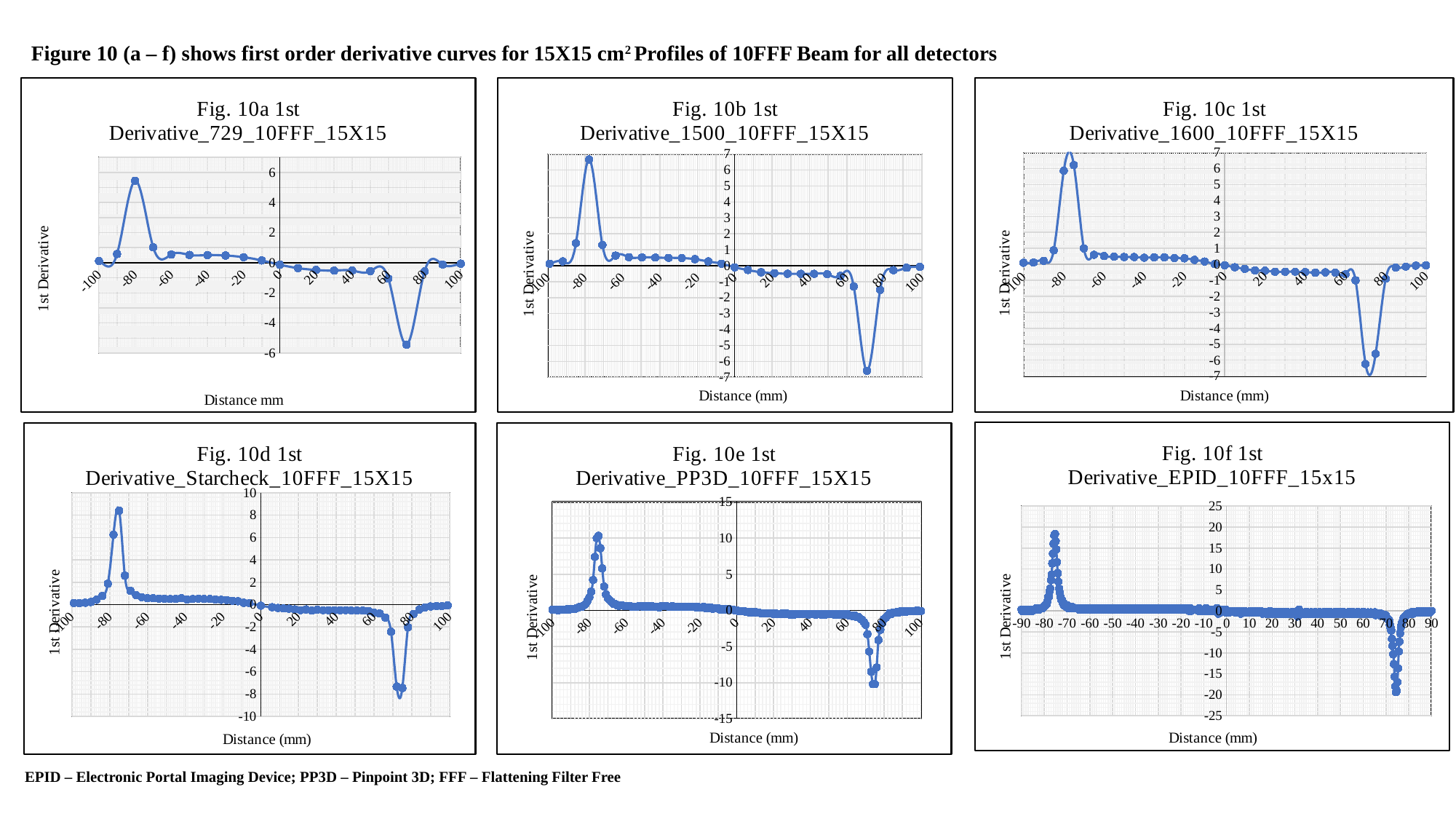
What kind of chart is Fig. 10a 1st Derivative_729_10FFF_15X15? Line chart In Fig. 10d 1st Derivative_Starcheck_10FFF_15X15, is the peak value near -70 mm greater or less than 6? greater In Fig. 10f 1st Derivative_EPID_10FFF_15x15, is the peak value near -75 mm greater or less than 15? greater What is the highest y-axis tick value shown in Fig. 10f 1st Derivative_EPID_10FFF_15x15? 25 In Fig. 10f 1st Derivative_EPID_10FFF_15x15, is the lowest value near 75 mm greater or less than -15? less What is the x-axis title of Fig. 10b 1st Derivative_1500_10FFF_15X15? Distance (mm) Which chart has the larger peak value, Fig. 10a 1st Derivative_729_10FFF_15X15 or Fig. 10f 1st Derivative_EPID_10FFF_15x15? Fig. 10f 1st Derivative_EPID_10FFF_15x15